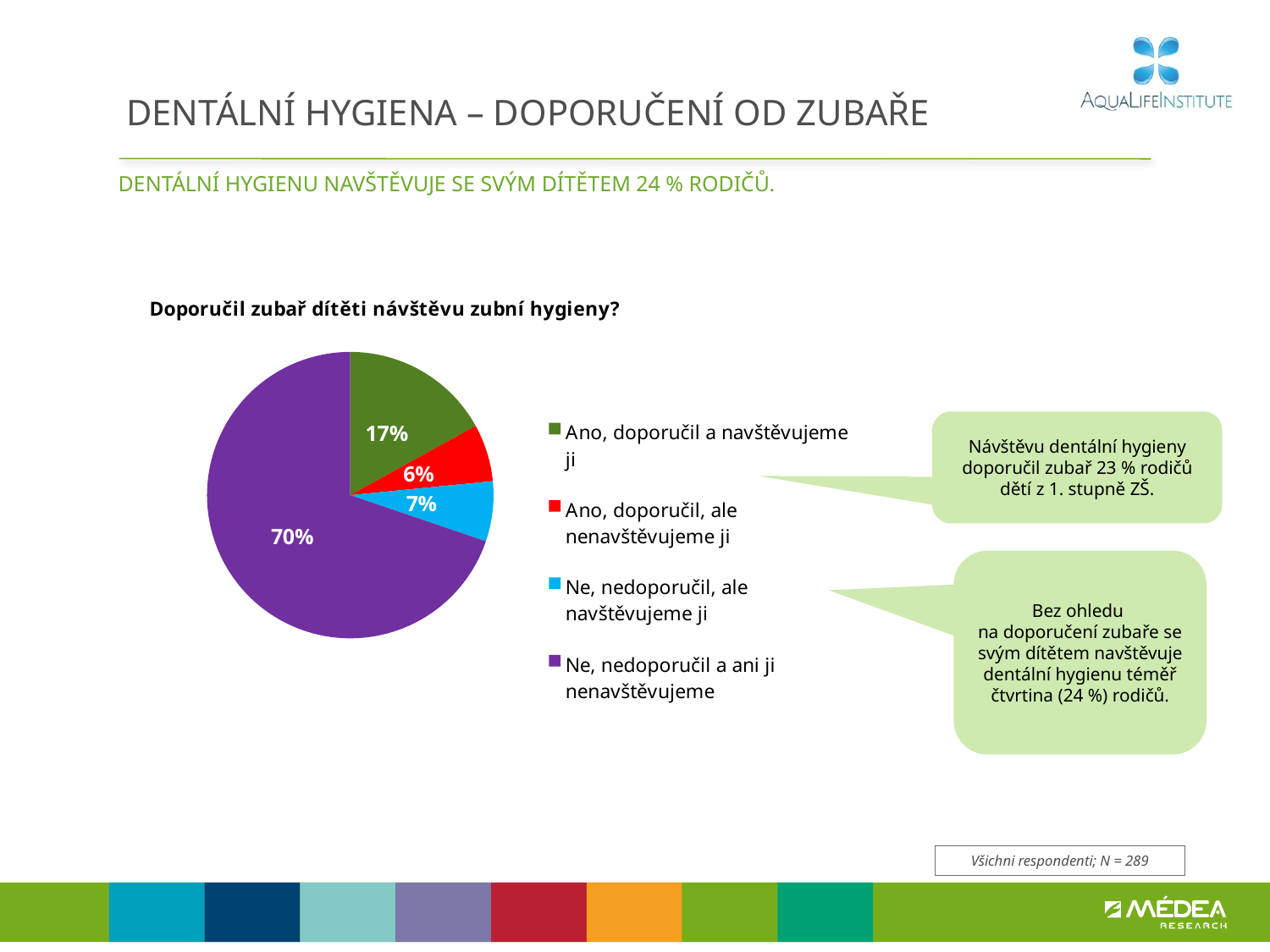
Which answer category has the largest share of the pie? Ne, nedoporučil a ani ji nenavštěvujeme What is the title of the chart? Doporučil zubař dítěti návštěvu zubní hygieny? What percentage of respondents answered "Ne, nedoporučil, ale navštěvujeme ji"? 7% What is the difference in percentage points between "Ne, nedoporučil a ani ji nenavštěvujeme" and "Ano, doporučil a navštěvujeme ji"? 53 percentage points What colour is the slice for "Ne, nedoporučil a ani ji nenavštěvujeme"? Purple Which is larger: the share for "Ano, doporučil a navštěvujeme ji" or the share for "Ne, nedoporučil, ale navštěvujeme ji"? Ano, doporučil a navštěvujeme ji Which answer category has the smallest share of the pie? Ano, doporučil, ale nenavštěvujeme ji What type of chart is shown on the slide? Pie chart What percentage of respondents answered "Ne, nedoporučil a ani ji nenavštěvujeme"? 70% What percentage of respondents answered "Ano, doporučil, ale nenavštěvujeme ji"? 6% What percentage of respondents answered "Ano, doporučil a navštěvujeme ji"? 17% How many categories does the legend list? 4